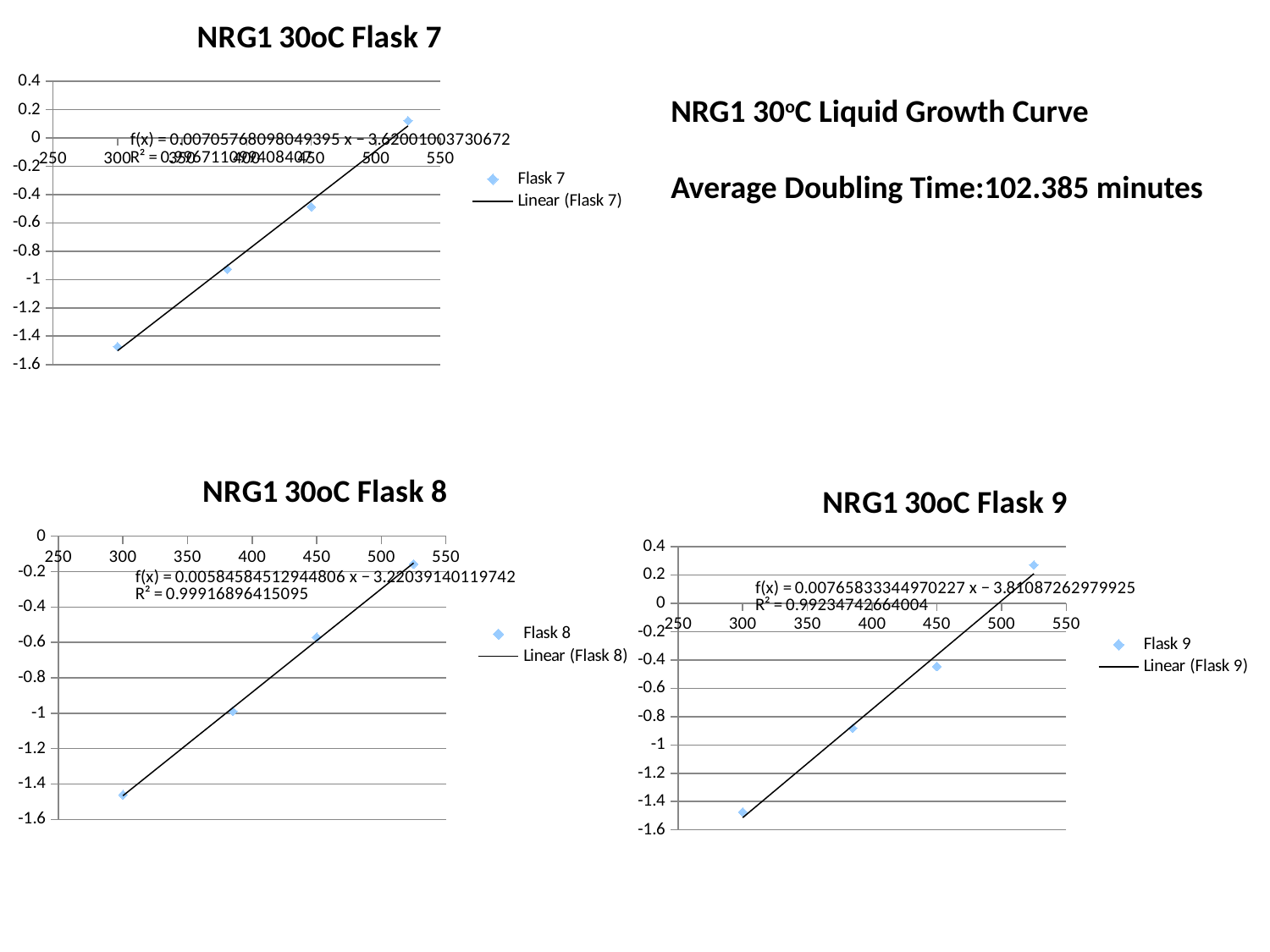
In the 'NRG1 30oC Flask 7' chart, is the value of the rightmost data point greater or less than 0? greater What type of chart is the 'NRG1 30oC Flask 7' chart? scatter chart What R² value is printed on the 'NRG1 30oC Flask 8' chart? 0.99916896415095 In the 'NRG1 30oC Flask 8' chart, is the value of the leftmost data point greater or less than -1.4? less In the 'NRG1 30oC Flask 9' chart, is the value of the rightmost data point greater or less than 0? greater How many data points are plotted in the 'NRG1 30oC Flask 9' chart? 4 In the 'NRG1 30oC Flask 8' chart, at which x-axis value does the lowest data point occur? 300 How many data points are plotted in the 'NRG1 30oC Flask 7' chart? 4 How many entries does the legend of the 'NRG1 30oC Flask 8' chart list? 2 In the 'NRG1 30oC Flask 9' chart, which data point is higher: the one at x = 300 or the one at x = 450? the one at x = 450 In the 'NRG1 30oC Flask 9' chart, do the plotted values rise or fall as x increases? rise What is the name of the line series in the legend of the 'NRG1 30oC Flask 9' chart? Linear (Flask 9)